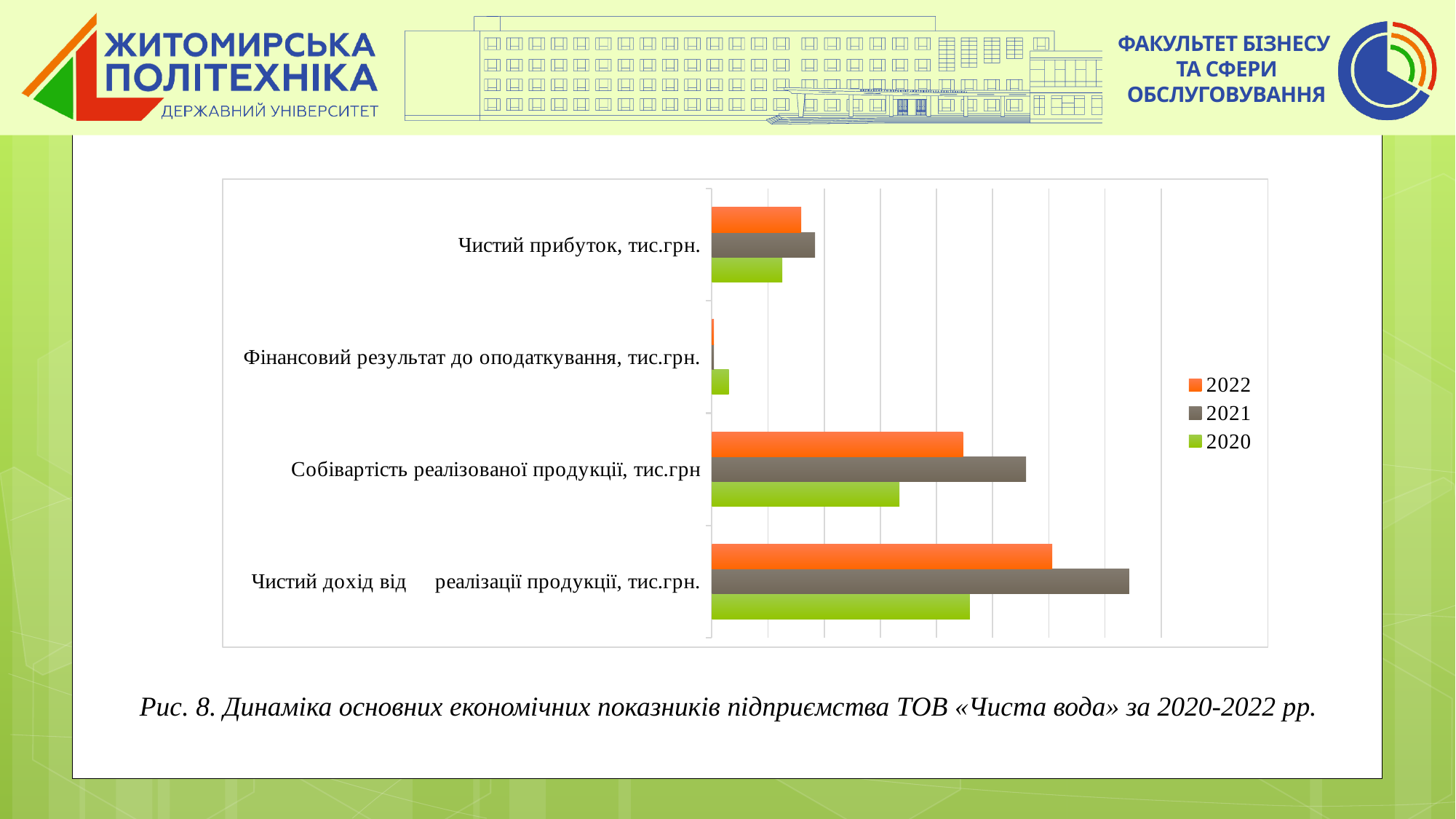
For 'Чистий дохід від реалізації продукції, тис.грн.', which year has the lowest value? 2020 For 'Чистий дохід від реалізації продукції, тис.грн.', which year has the highest value? 2021 Which years are listed in the chart legend? 2022, 2021, 2020 How many categories (indicators) are plotted on the chart? 4 What kind of chart is shown on the slide? Bar chart For 'Фінансовий результат до оподаткування, тис.грн.', which year has the highest value? 2020 How many series does the chart legend list? 3 For 'Собівартість реалізованої продукції, тис.грн', which year has the highest value? 2021 According to the caption, what figure number is this chart? Рис. 8 For 'Чистий прибуток, тис.грн.', which year has the lowest value? 2020 For 'Собівартість реалізованої продукції, тис.грн', is the 2022 value larger or smaller than the 2020 value? Larger